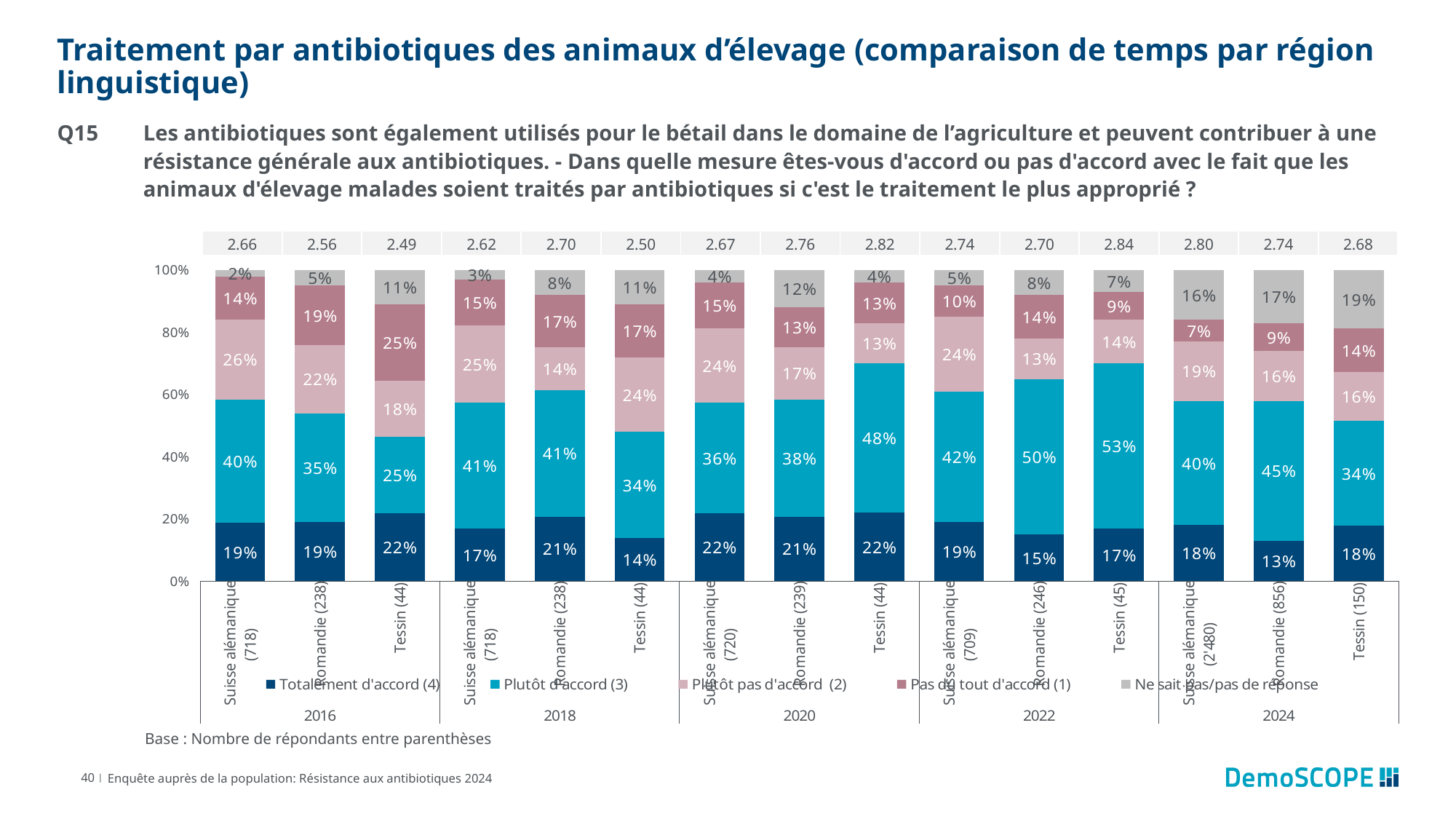
What is the "Ne sait pas/pas de réponse" share for Tessin (150) in 2024? 19% What kind of chart is shown on the slide? Stacked bar chart How many series does the legend list? 5 What is the mean score shown above the bar for Tessin (44) in 2016? 2.49 What is the difference in percentage points between the "Plutôt d'accord (3)" share for Suisse alémanique (2'480) and Tessin (150) in 2024? 6 percentage points What percentage of respondents in Romandie (856) in 2024 answered "Plutôt d'accord (3)"? 45% In 2022, which region has the larger "Plutôt d'accord (3)" share, Romandie (246) or Suisse alémanique (709)? Romandie (246) What percentage of respondents in Tessin (45) in 2022 answered "Totalement d'accord (4)"? 17% Which bar has the highest mean score shown above the chart? Tessin (45), 2022 (2.84) Which bar has the lowest "Totalement d'accord (4)" share? Romandie (856), 2024 Which bar has the highest "Plutôt d'accord (3)" share? Tessin (45), 2022 How many bars are plotted in the chart? 15